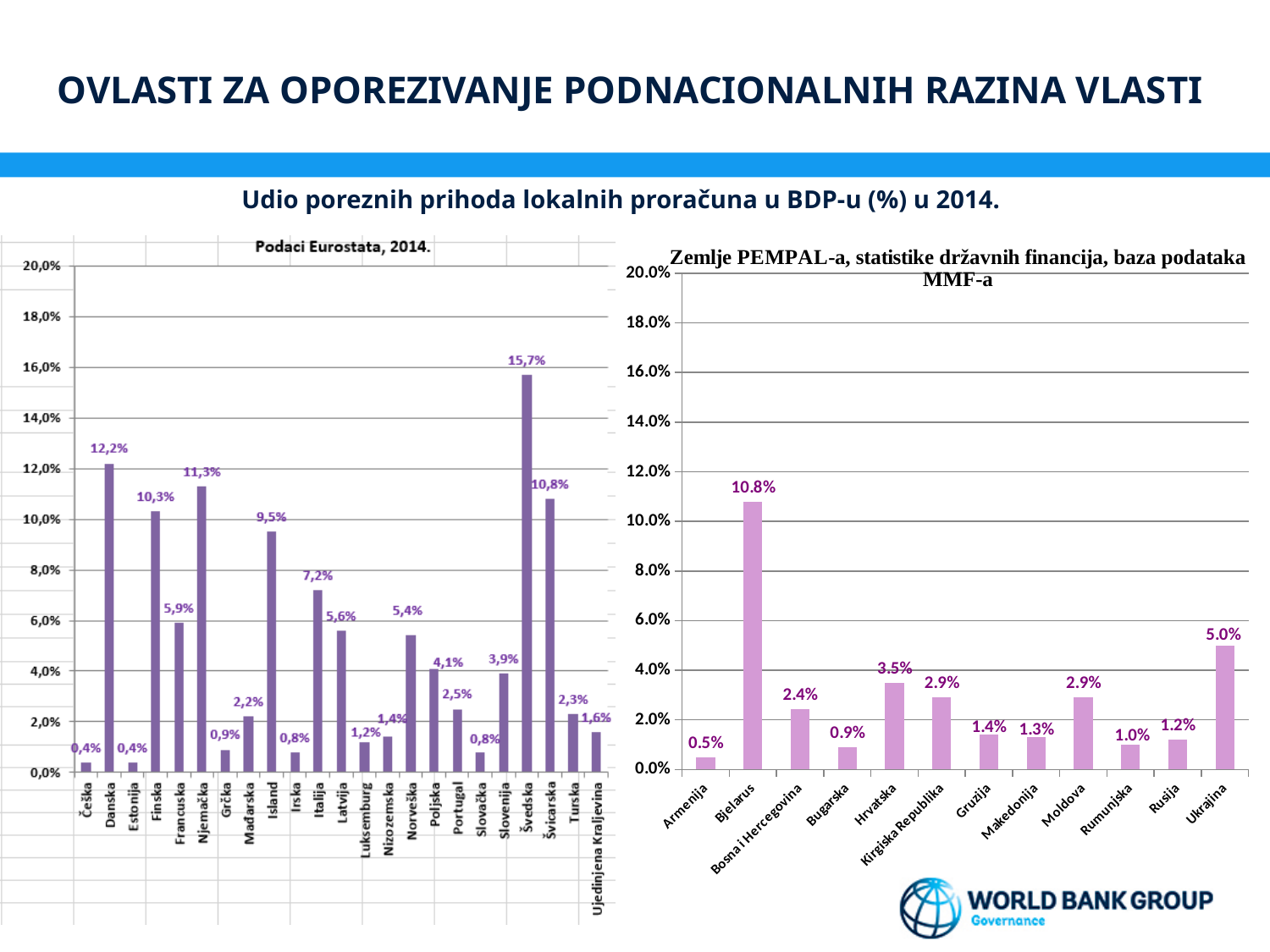
In the left chart (Podaci Eurostata, 2014.), which country has the highest value? Švedska What is the title of the left chart? Podaci Eurostata, 2014. In the right chart (Zemlje PEMPAL-a), how many countries are shown? 12 In the left chart (Podaci Eurostata, 2014.), what is the value for Island? 9,5% In the left chart (Podaci Eurostata, 2014.), what is the difference between Danska and Finska? 1,9% In the left chart (Podaci Eurostata, 2014.), what is the value for Švedska? 15,7% In the right chart (Zemlje PEMPAL-a), what is the difference between Hrvatska and Bosna i Hercegovina? 1.1% In the right chart (Zemlje PEMPAL-a), what is the value for Bjelarus? 10.8% What type of chart is the right chart (Zemlje PEMPAL-a)? Bar chart In the right chart (Zemlje PEMPAL-a), which country has the lowest value? Armenija In the left chart (Podaci Eurostata, 2014.), which is larger, Italija or Latvija? Italija In the right chart (Zemlje PEMPAL-a), what is the value for Ukrajina? 5.0%